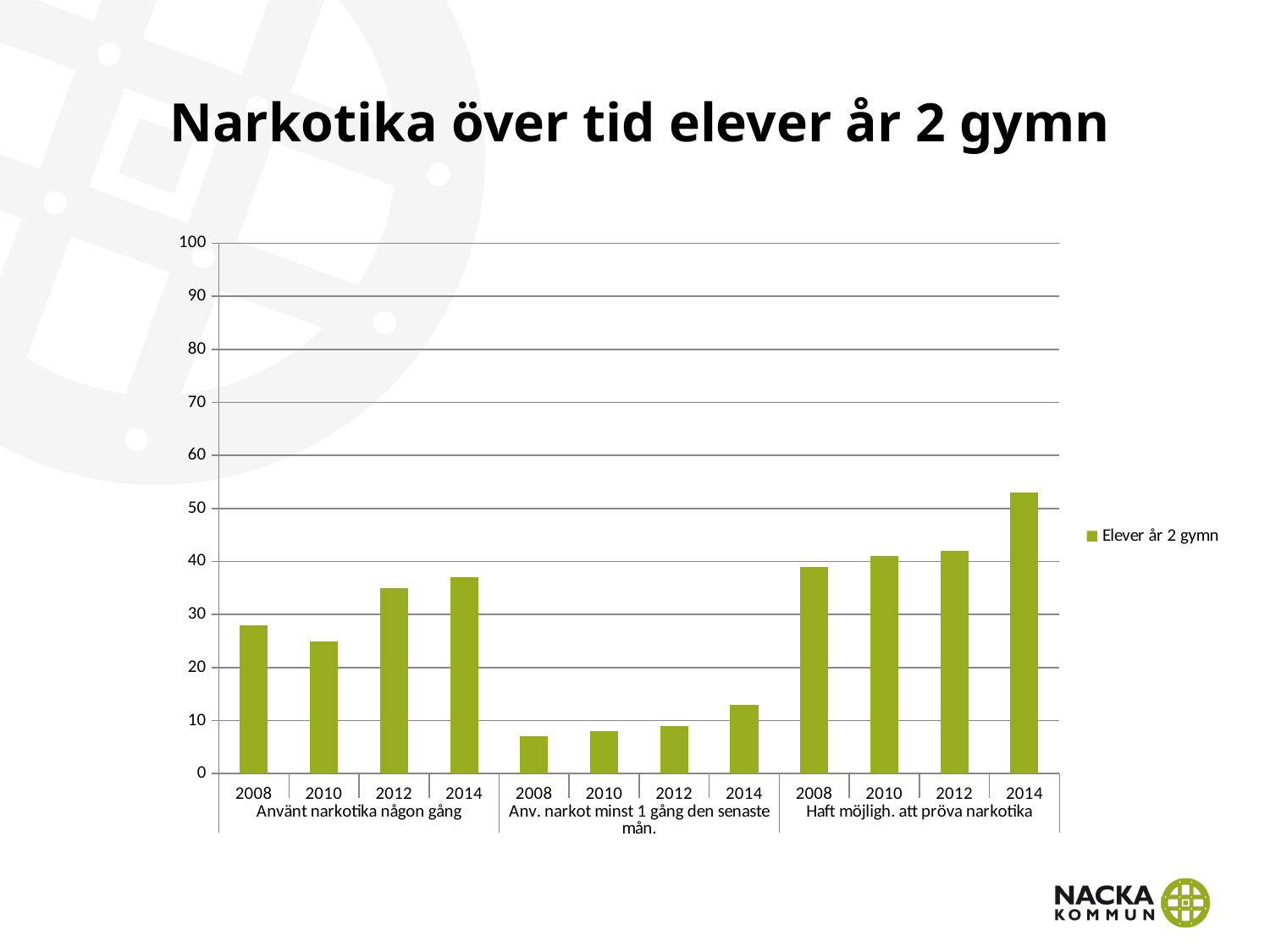
Which bar is the highest in the chart? 2014, Haft möjligh. att pröva narkotika What kind of chart is shown on the slide? bar chart How many series does the legend list? 1 What is the name of the series in the legend? Elever år 2 gymn How many bars are plotted in the chart? 12 Is the value for 2014 under 'Haft möjligh. att pröva narkotika' greater or less than 50? greater How many category groups are shown along the x axis? 3 Do the values for 'Haft möjligh. att pröva narkotika' rise or fall from 2008 to 2014? rise Is the value for 2014 under 'Anv. narkot minst 1 gång den senaste mån.' greater or less than 20? less What is the title of the chart? Narkotika över tid elever år 2 gymn Which is larger: the 2014 value for 'Använt narkotika någon gång' or the 2014 value for 'Haft möjligh. att pröva narkotika'? Haft möjligh. att pröva narkotika Which category group has the lowest values overall? Anv. narkot minst 1 gång den senaste mån.